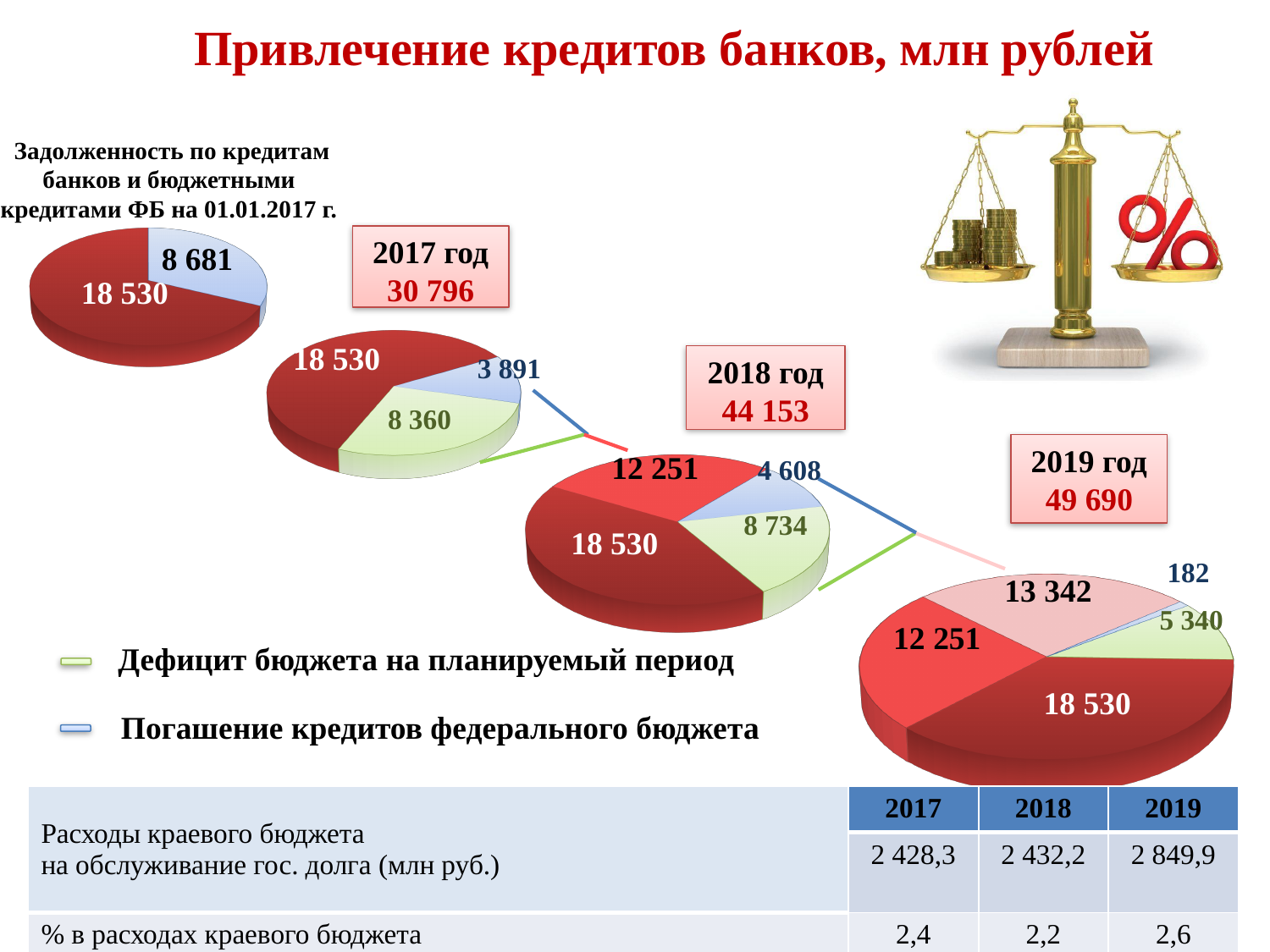
In the pie chart for 01.01.2017 (Задолженность по кредитам банков и бюджетными кредитами ФБ), what is the value of the largest slice? 18 530 In the 2018 год pie chart, which is larger: the slice labelled 12 251 or the slice labelled 8 734? 12 251 In the 2019 год pie chart, what is the value of the smallest slice? 182 How many pie charts are shown on the slide? 4 Do the total values shown in the boxes for 2017 год, 2018 год and 2019 год rise or fall over the years? Rise In the 2018 год pie chart, what is the value of the blue slice (Погашение кредитов федерального бюджета)? 4 608 In the pie chart for 01.01.2017, what is the difference between the two slices, 18 530 and 8 681? 9 849 What kind of charts are used on the slide to show the bank credit figures? Pie charts What total value is shown in the box for 2019 год? 49 690 By how much does the green slice (Дефицит бюджета) in the 2018 год pie chart exceed the green slice in the 2017 год pie chart? 374 In the 2017 год pie chart, what is the value of the green slice (Дефицит бюджета на планируемый период)? 8 360 Which legend entry is marked with the green colour? Дефицит бюджета на планируемый период